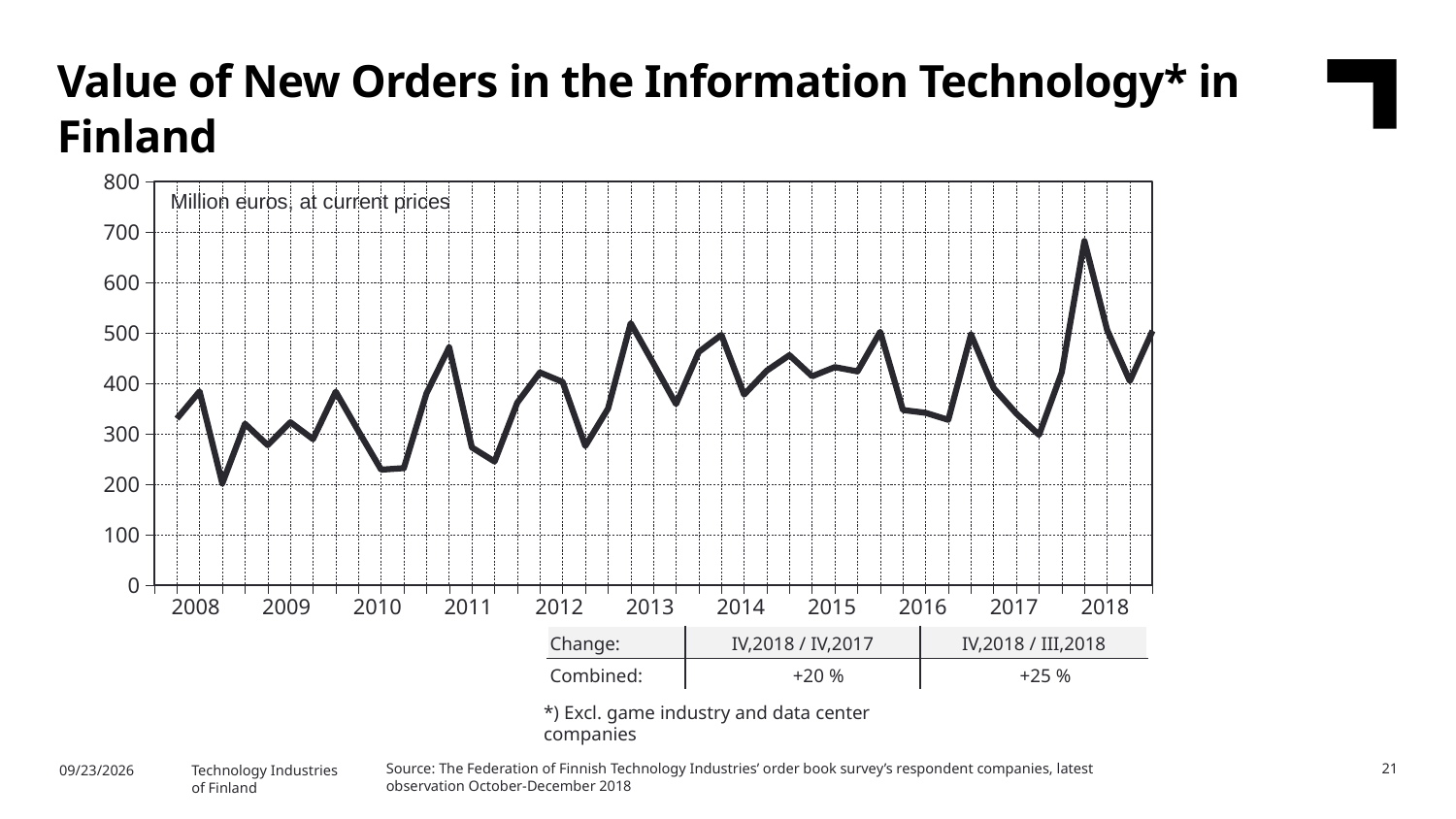
How many years are labelled on the x axis? 11 In what unit are the values on the chart expressed? Million euros, at current prices Is the lowest value in 2008 greater or less than 300? less What kind of chart is shown on the slide? line chart What is the combined change for IV,2018 / III,2018 shown in the table below the chart? +25 % Is the value at the end of 2018 higher or lower than the value at the start of 2008? higher Is the peak value in 2013 greater or less than 400? greater What is the combined change for IV,2018 / IV,2017 shown in the table below the chart? +20 % Is the lowest value in 2010 greater or less than 300? less In which year does the line reach its highest peak? 2018 In which year does the line reach its lowest point? 2008